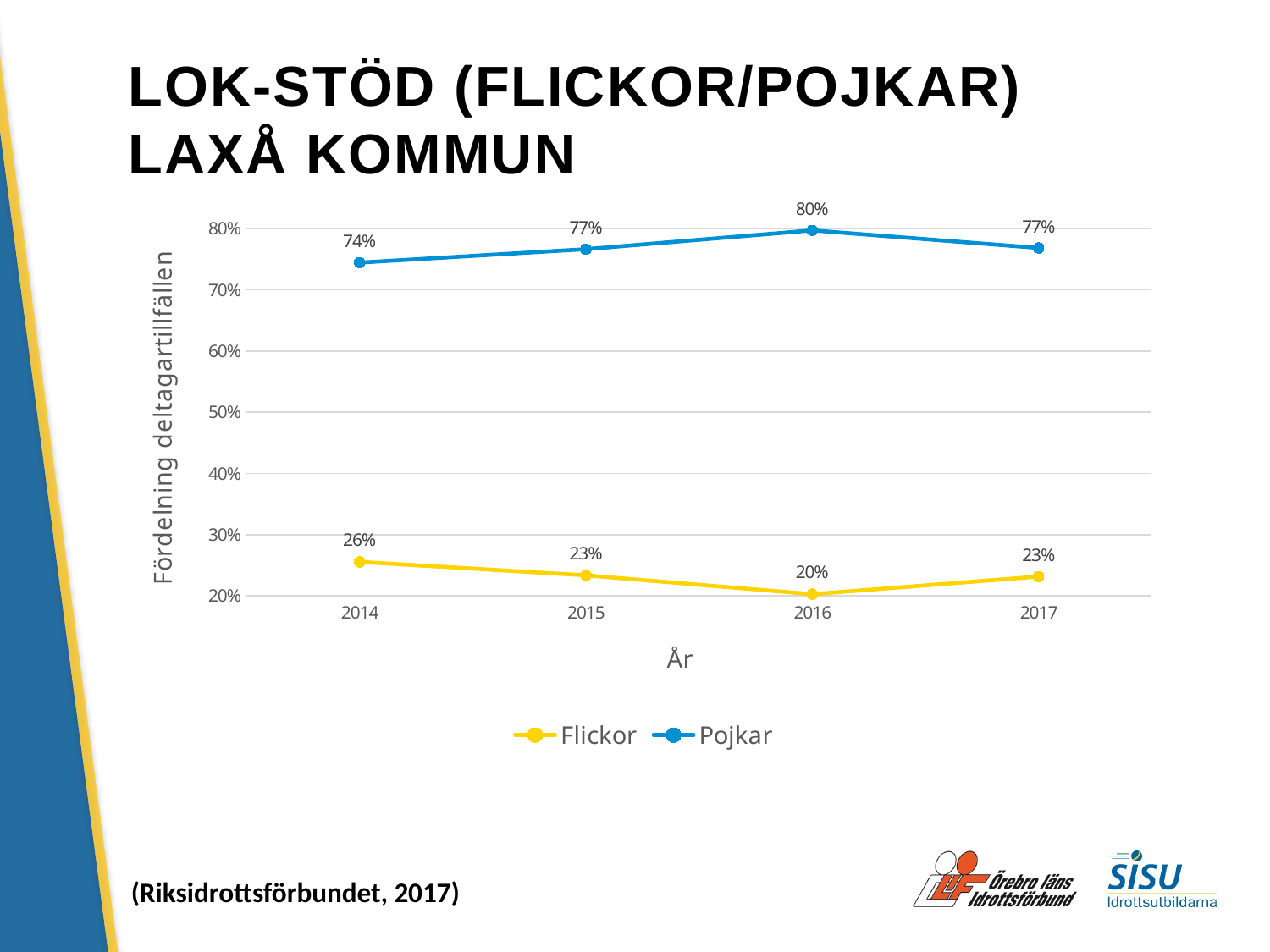
What is the value for Pojkar in 2016? 80% How many series does the legend list? 2 What kind of chart is shown on the slide? Line chart How many years are shown on the x axis? 4 What is the label of the y axis? Fördelning deltagartillfällen What is the value for Flickor in 2014? 26% Which series has the larger value in 2017, Flickor or Pojkar? Pojkar In which year is the Flickor value lowest? 2016 What is the difference between the Pojkar and Flickor values in 2014? 48% What is the value for Flickor in 2016? 20% In which year is the Pojkar value highest? 2016 What is the value for Pojkar in 2015? 77%